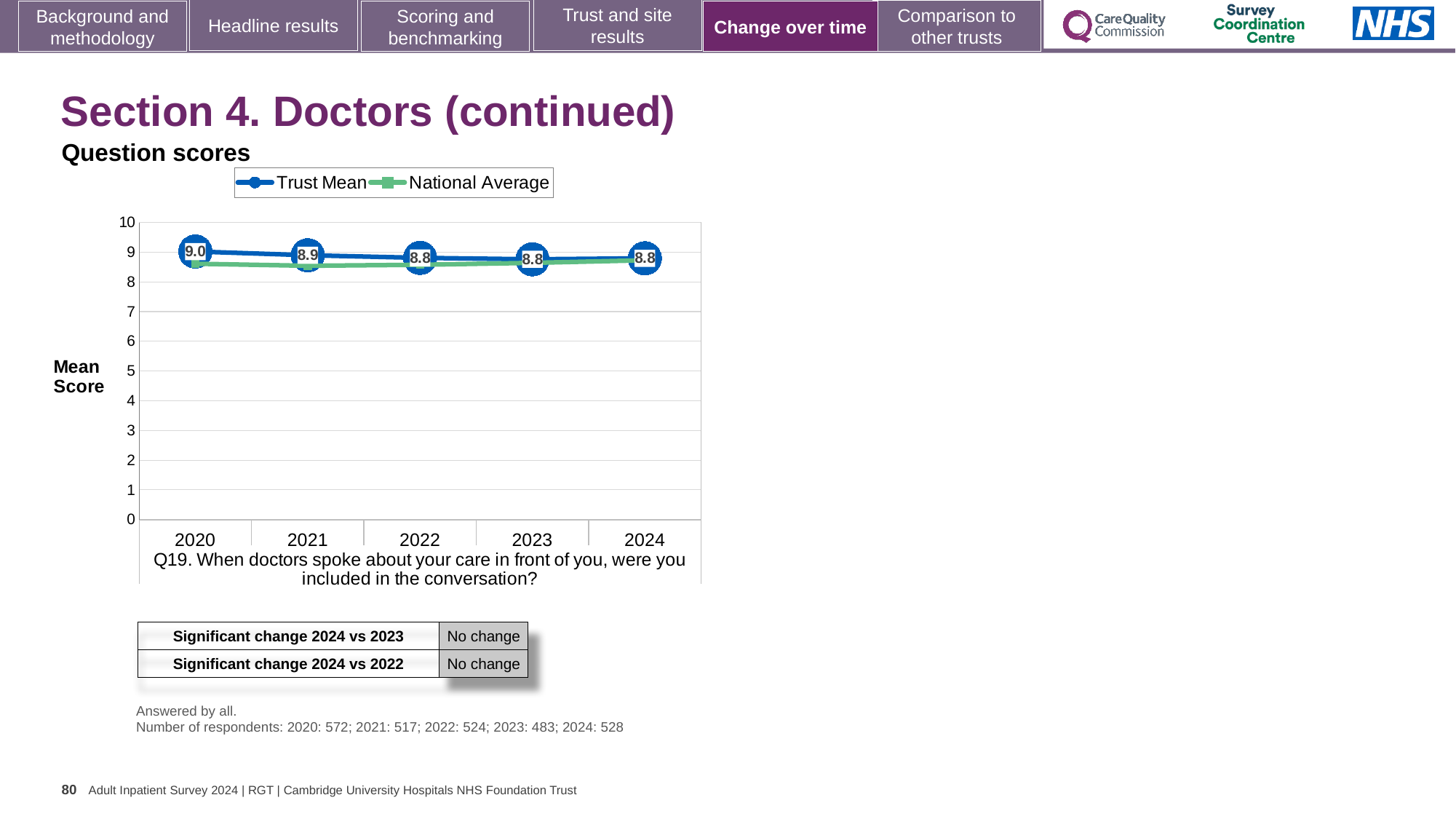
How many series does the legend list? 2 What is the Trust Mean score for 2020? 9.0 What kind of chart is shown on the slide? Line chart Does the Trust Mean score rise or fall from 2020 to 2024? Fall What is the difference between the Trust Mean score in 2020 and in 2024? 0.2 Which year has the larger Trust Mean score, 2020 or 2021? 2020 In which year is the Trust Mean score highest? 2020 What is the Trust Mean score for 2021? 8.9 Is the National Average value for 2020 greater or less than 8? greater What is the label of the y axis? Mean Score What is the Trust Mean score for 2024? 8.8 How many years are plotted on the x axis? 5